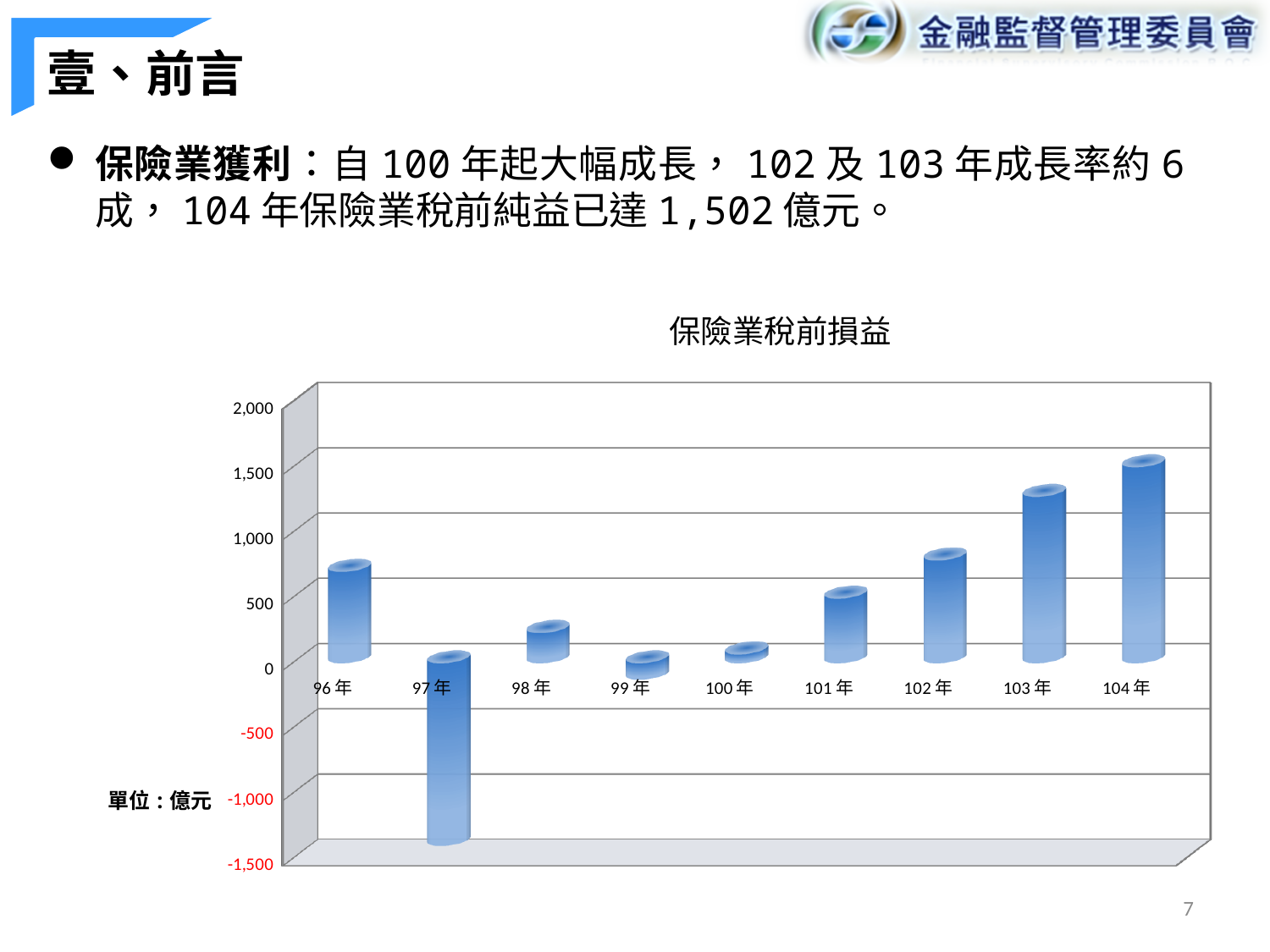
Is the value for 97年 greater or less than -1,000? less What kind of chart is shown on the slide? bar chart Which year has the lowest value in the chart? 97年 What is the title of the chart? 保險業稅前損益 Is the value for 98年 greater or less than 500? less Do the values rise or fall from 100年 to 104年? rise Which year has the highest value in the chart? 104年 Which is larger, the value for 103年 or the value for 96年? 103年 Is the value for 96年 greater or less than 500? greater What unit is stated for the values in the chart? 億元 How many years (categories) are plotted on the x axis of the chart? 9